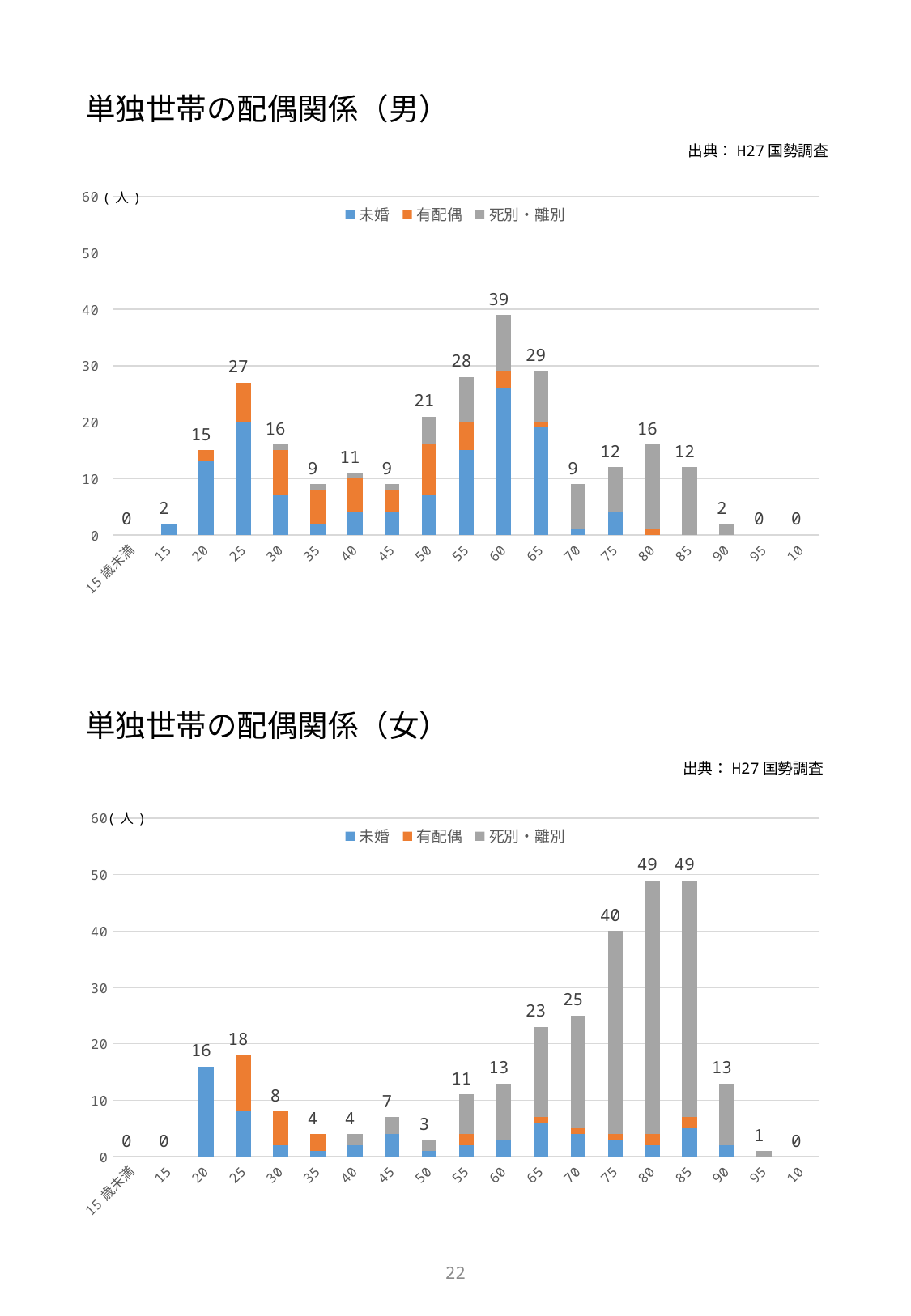
In the chart titled 単独世帯の配偶関係（男）, which is larger, the total for the 25 age group or the total for the 50 age group? 25 In the chart titled 単独世帯の配偶関係（男）, which age group has the highest total? 60 In the chart titled 単独世帯の配偶関係（女）, is the total for the 65 age group greater or less than 20? greater In the chart titled 単独世帯の配偶関係（女）, what is the total value shown for the 75 age group? 40 In the chart titled 単独世帯の配偶関係（女）, which is larger, the total for the 20 age group or the total for the 25 age group? 25 In the chart titled 単独世帯の配偶関係（男）, what is the total value shown for the 80 age group? 16 In the chart titled 単独世帯の配偶関係（女）, what is the difference between the totals for the 80 and 90 age groups? 36 What kind of chart is the chart titled 単独世帯の配偶関係（女）? Stacked bar chart In the chart titled 単独世帯の配偶関係（男）, what is the total value shown for the 60 age group? 39 In the chart titled 単独世帯の配偶関係（女）, what is the third series listed in the legend? 死別・離別 In the chart titled 単独世帯の配偶関係（男）, how many series does the legend list? 3 In the chart titled 単独世帯の配偶関係（男）, what is the difference between the totals for the 55 and 65 age groups? 1